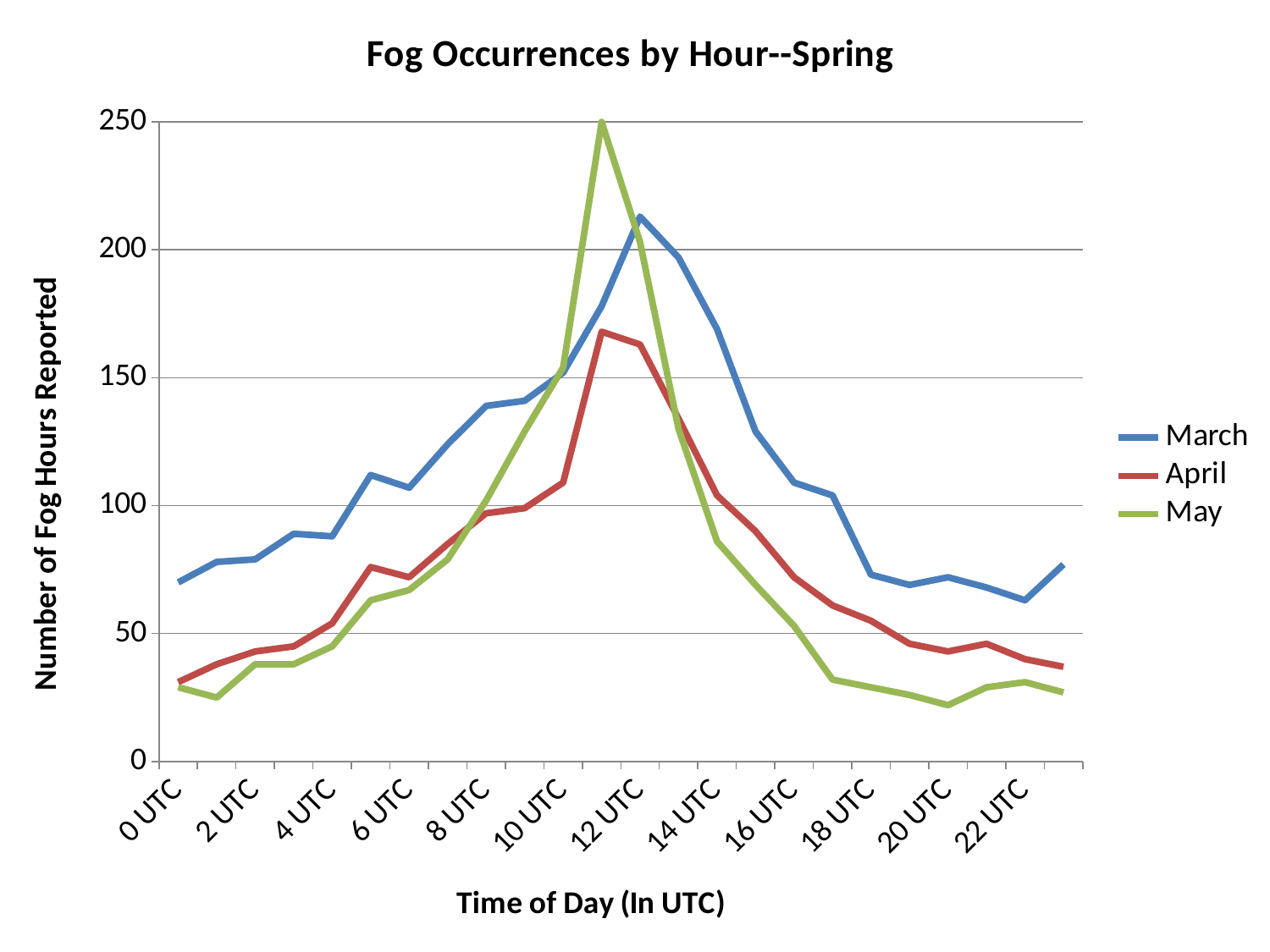
Do the values for May rise or fall between 11 UTC and 18 UTC? fall What is the label of the vertical axis? Number of Fog Hours Reported Which series has the lowest value at 0 UTC? May Is the value for May at 20 UTC greater or less than 50? less Which series reaches the highest peak value on the chart? May What kind of chart is shown on the slide? Line chart At 18 UTC, which series has the larger value, April or May? April Is the value for April at 11 UTC greater or less than 150? greater Is the value for March at 12 UTC greater or less than 200? greater How many series does the legend list? 3 What is the title of the chart? Fog Occurrences by Hour--Spring At 12 UTC, which series has the larger value, March or April? March